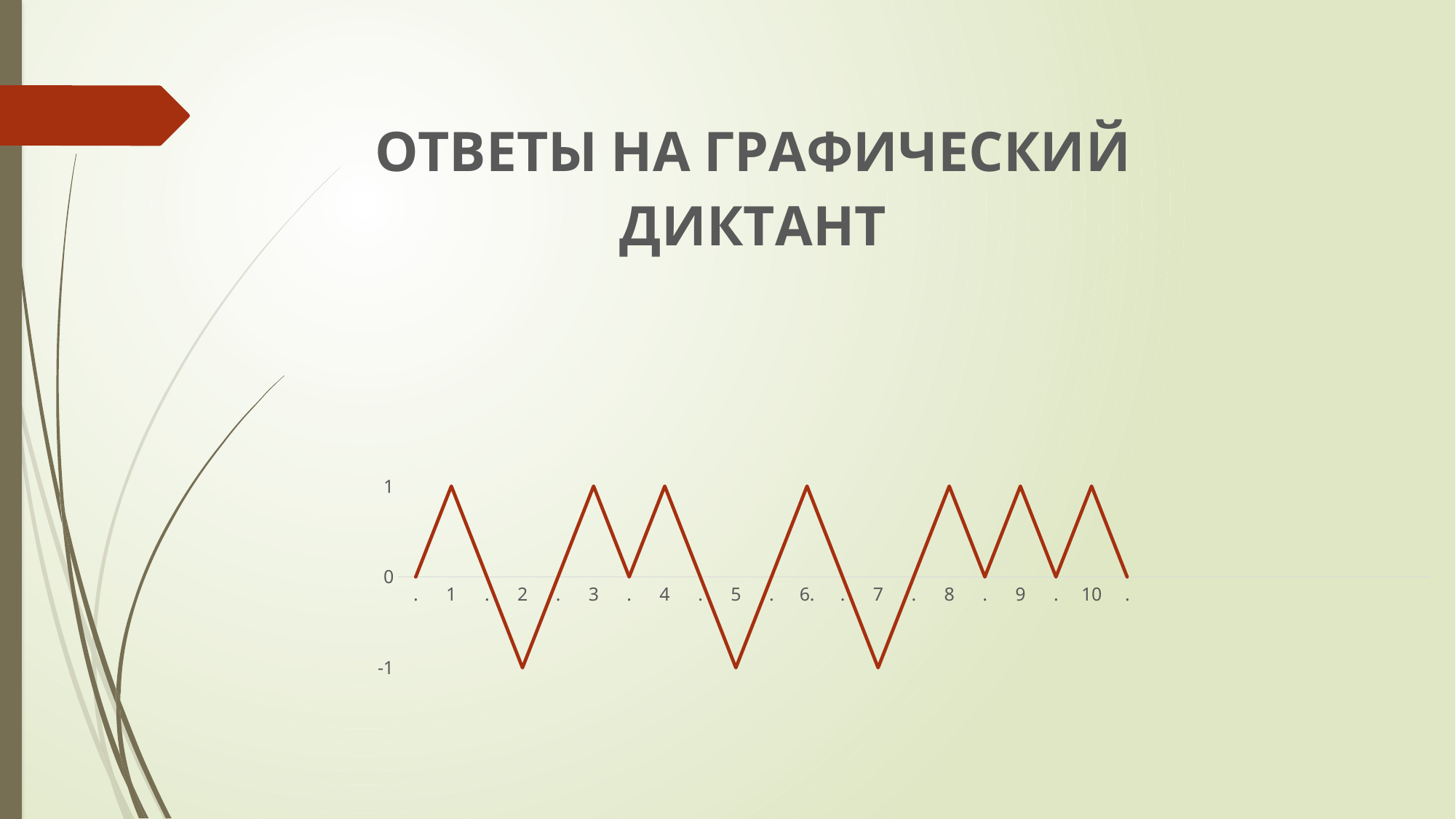
Which is larger, the value at category 3 or the value at category 2? category 3 What is the lowest value the line reaches? -1 What is the value of the line at category 1? 1 At how many numbered categories does the line reach -1? 3 What kind of chart is shown on the slide? line chart What is the value of the line at category 9? 1 What colour is the line in the chart? red What is the title of the slide containing the chart? ОТВЕТЫ НА ГРАФИЧЕСКИЙ ДИКТАНТ What is the value of the line at category 5? -1 What is the value of the line at category 2? -1 How many numbered categories (1 to 10) are labelled on the x axis? 10 What is the difference between the value at category 1 and the value at category 2? 2